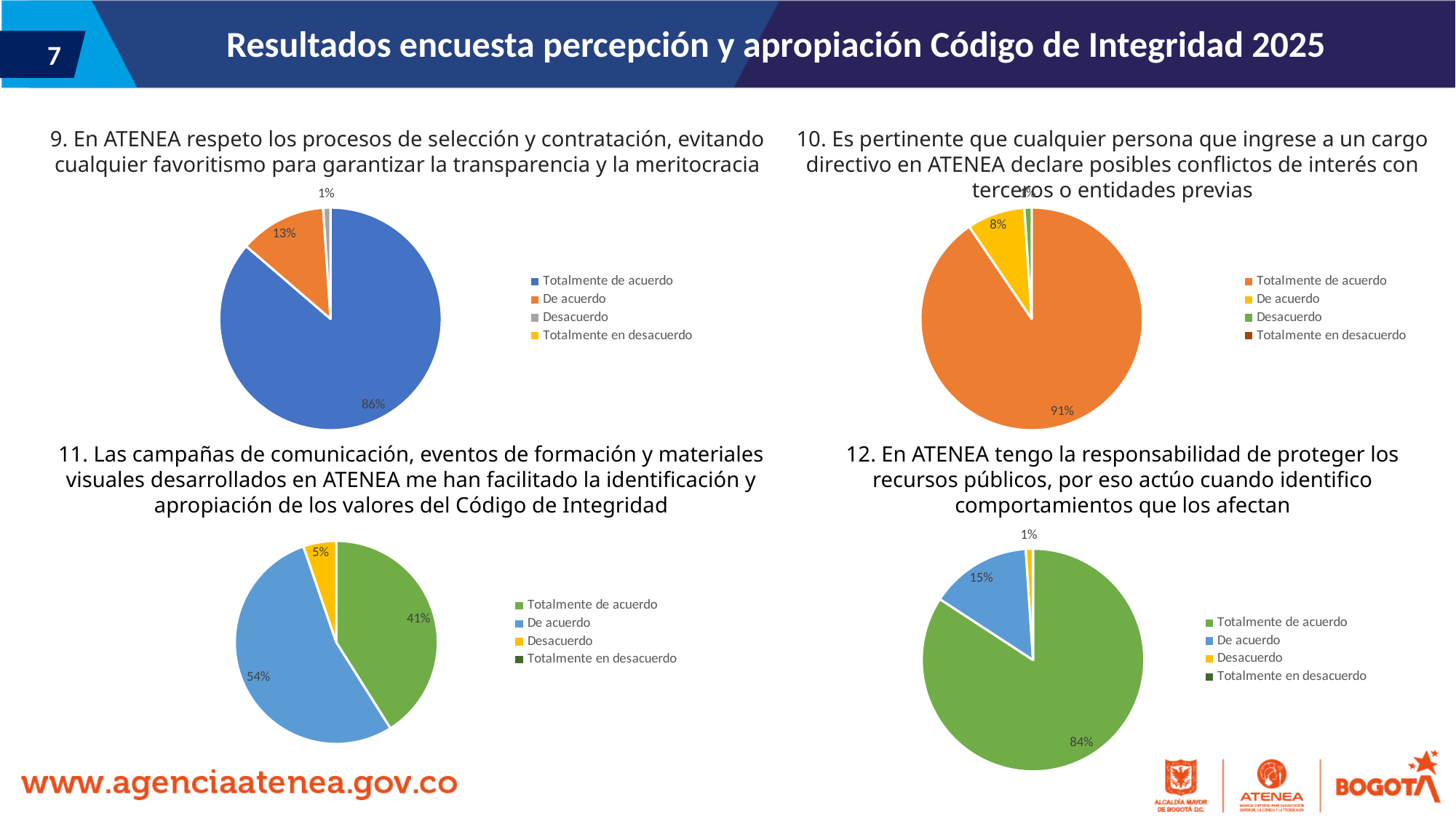
In the chart for question 11 (bottom-left), what is the difference between the 'De acuerdo' and 'Totalmente de acuerdo' shares? 13% What type of chart is used for question 9 (top-left)? Pie chart In the chart for question 10 (top-right), what percentage answered 'De acuerdo'? 8% In the chart for question 9 (top-left), what percentage answered 'De acuerdo'? 13% In the chart for question 12 (bottom-right), what is the difference between the 'Totalmente de acuerdo' and 'De acuerdo' shares? 69% In the chart for question 12 (bottom-right), what percentage answered 'Totalmente de acuerdo'? 84% In the chart for question 10 (top-right), what percentage answered 'Totalmente de acuerdo'? 91% In the chart for question 11 (bottom-left), which response category has the largest share? De acuerdo In the chart for question 12 (bottom-right), which is larger: the 'De acuerdo' share or the 'Desacuerdo' share? De acuerdo How many entries does the legend of the chart for question 10 (top-right) list? 4 In the chart for question 11 (bottom-left), what percentage answered 'Desacuerdo'? 5% In the chart for question 9 (top-left), what percentage of respondents answered 'Totalmente de acuerdo'? 86%